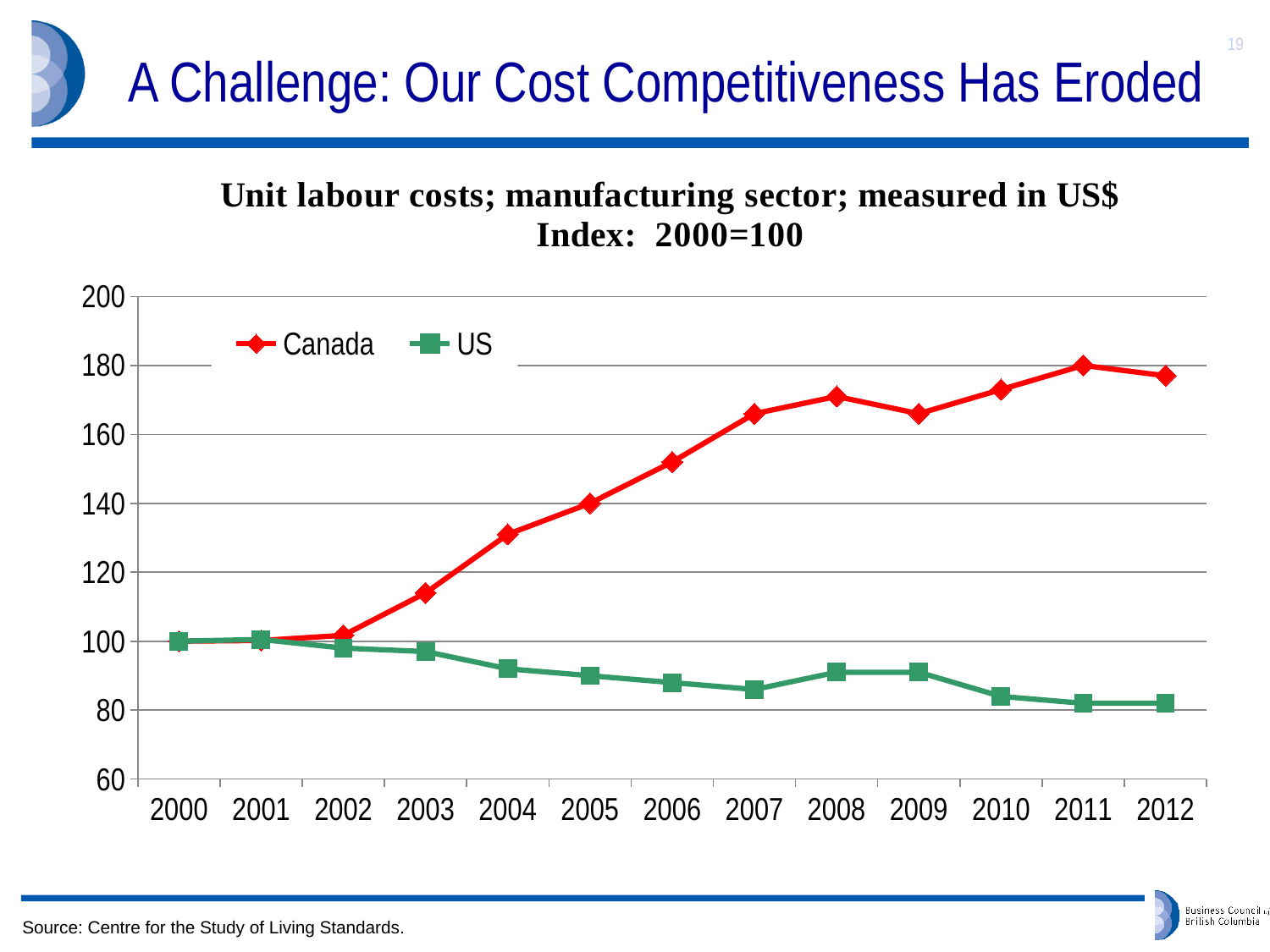
Does the US series generally rise or fall from 2000 to 2012? fall What colour is the line for Canada? red What is the index value for Canada in 2000? 100 Is the value for Canada in 2006 greater or less than 140? greater How many series does the legend list? 2 Is the value for US in 2007 greater or less than 100? less Is the value for US in 2012 greater or less than 100? less In which year does the Canada series reach its highest value? 2011 What kind of chart is shown on the slide? line chart How many years are plotted along the x axis? 13 Which series has the larger value in 2012, Canada or US? Canada